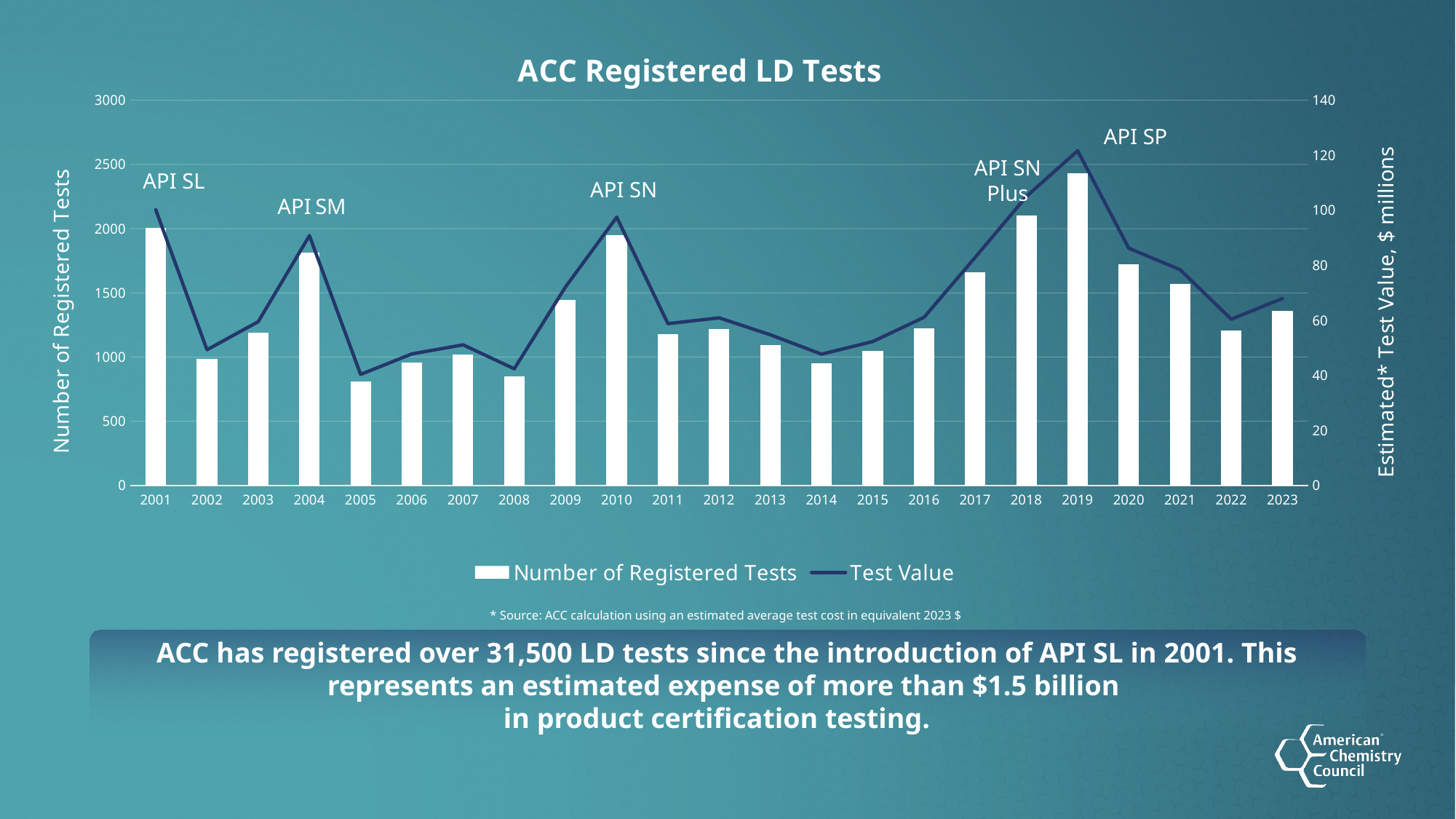
How many series does the legend list? 2 Is the number of registered tests in 2005 greater or less than 1000? less Do the number of registered tests rise or fall from 2014 to 2019? rise What is the title of the chart? ACC Registered LD Tests Is the Test Value for 2019 greater or less than 100 ($ millions)? greater Is the number of registered tests in 2001 greater or less than 1500? greater Which year has the highest number of registered tests? 2019 Which year has more registered tests, 2018 or 2020? 2018 How many years are shown on the x axis? 23 What label is shown above the 2019 peak of the chart? API SP Which year has more registered tests, 2010 or 2011? 2010